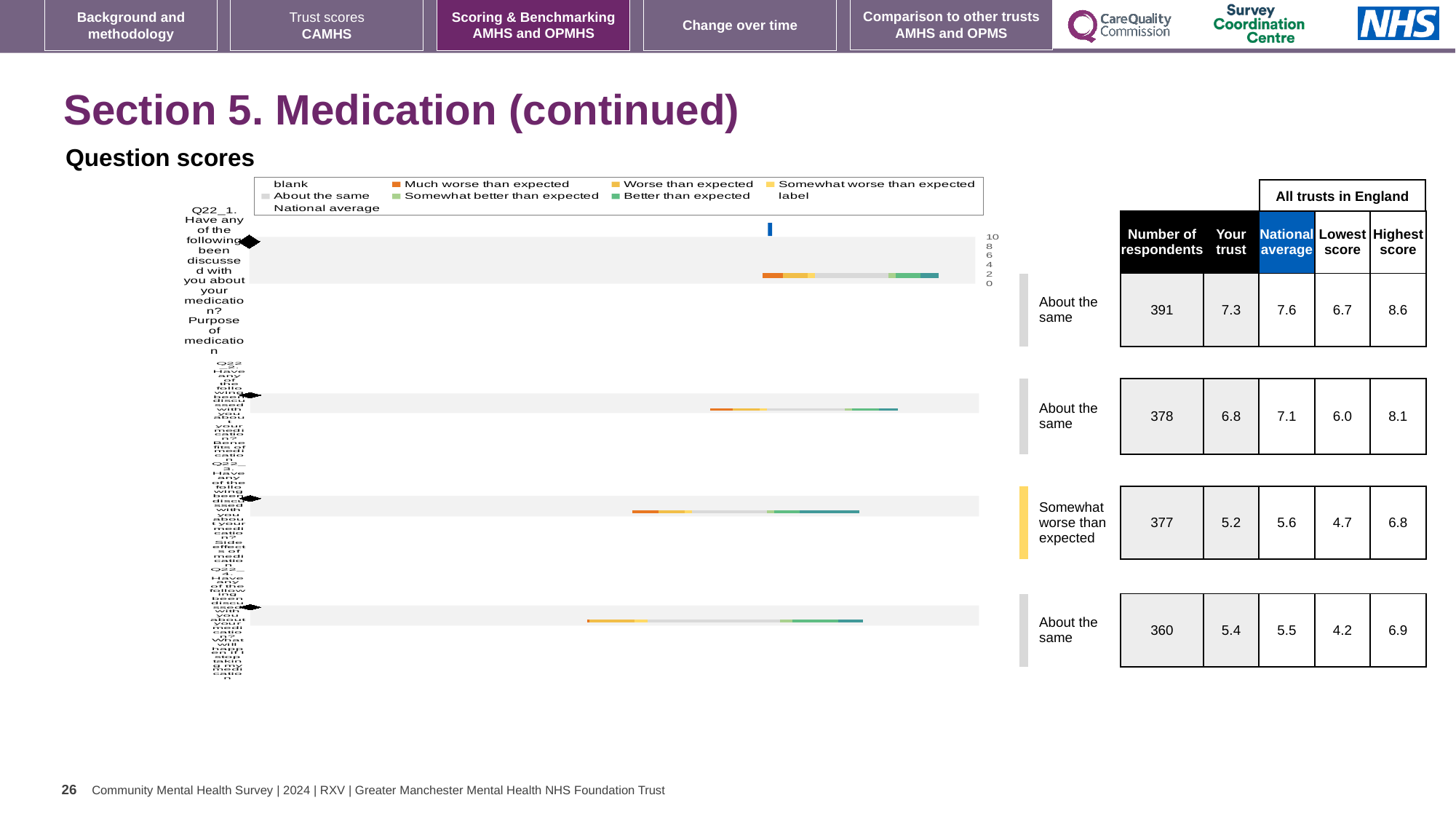
What is the highest value shown on the chart's score axis? 10 Which is larger for Q22_1 (Purpose of medication): the 'Your trust' score or the national average? National average What kind of chart is shown on the slide? bar chart Which of the four questions has the highest 'Your trust' score? The first question (Q22_1, Purpose of medication), 7.3 How many question bars are plotted in the chart? 4 What is the difference between the national average and the 'Your trust' score for Q22_1 (Purpose of medication)? 0.3 What is the national average for Q22_1 (Purpose of medication)? 7.6 What colour does the legend use for 'Much worse than expected'? orange Which of the four questions has the lowest 'Your trust' score? The third question (Q22_3), 5.2 How many respondents answered Q22_1 (Purpose of medication)? 391 What benchmark category is shown for the third question (Q22_3)? Somewhat worse than expected What is the 'Your trust' score for Q22_1 (Purpose of medication)? 7.3